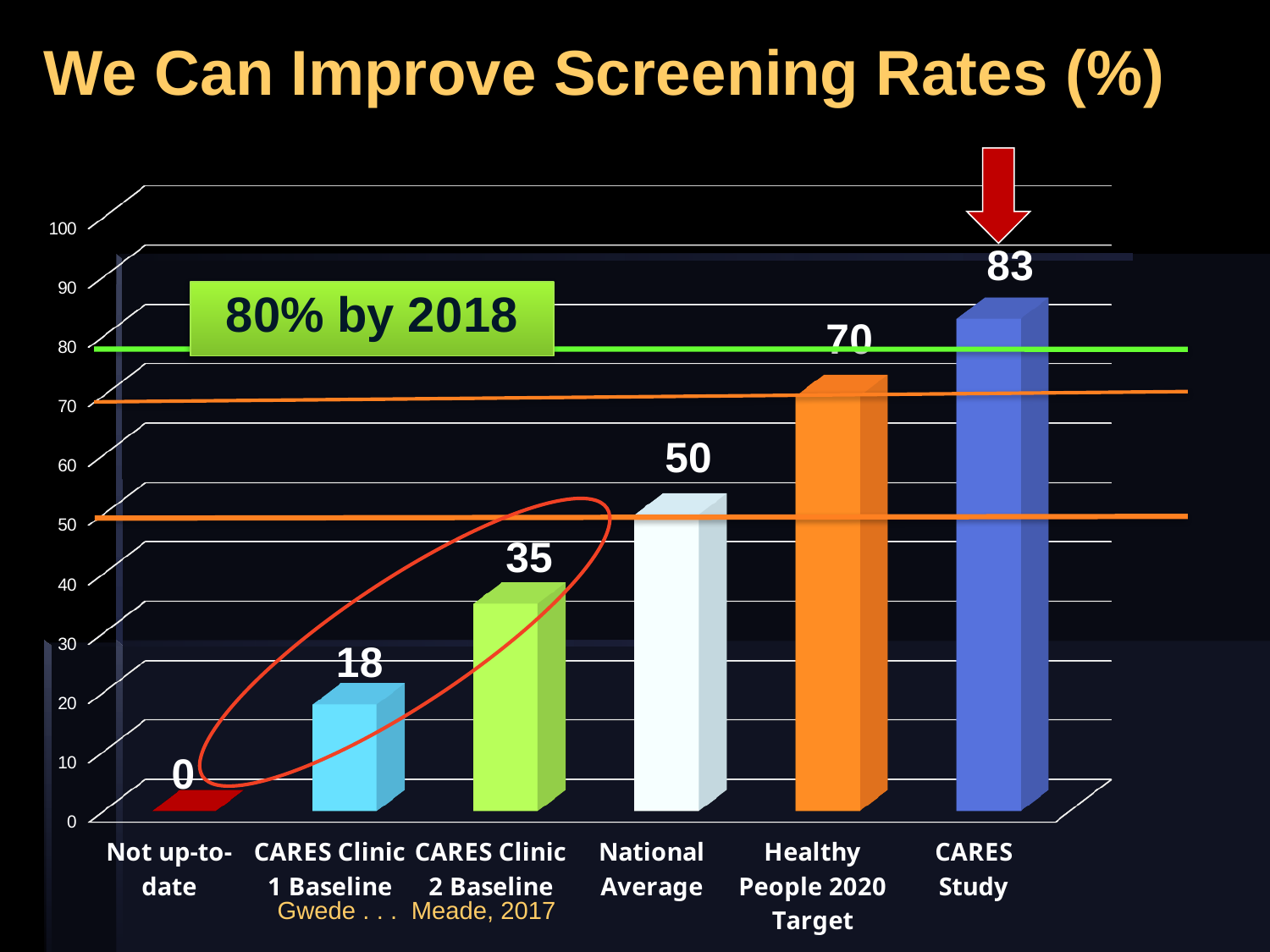
Which category has the lowest value? Not up-to-date Which is larger, the value for National Average or the value for CARES Clinic 2 Baseline? National Average What is the value for Healthy People 2020 Target? 70 What is the value for CARES Clinic 1 Baseline? 18 Which category has the highest value? CARES Study What kind of chart is this? bar chart What is the value for National Average? 50 How many categories are shown on the x axis? 6 What is the value for CARES Study? 83 What is the difference between the CARES Study value and the Healthy People 2020 Target value? 13 What is the title of the chart? We Can Improve Screening Rates (%) What is the difference between CARES Clinic 2 Baseline and CARES Clinic 1 Baseline? 17